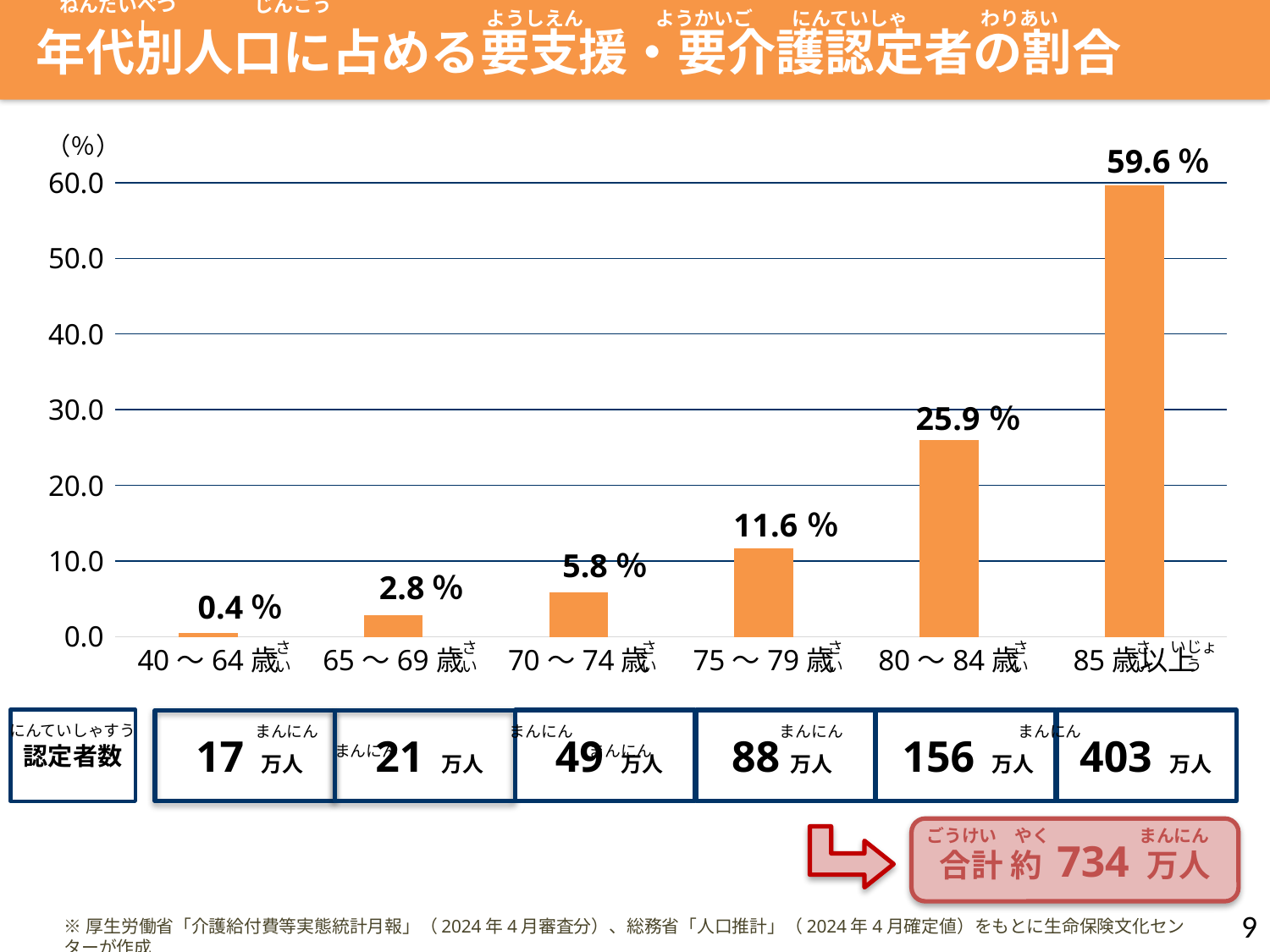
Is the value for 80～84歳 greater or less than 30.0? less What unit is shown at the top of the y axis? (%) Which is larger, the value for 70～74歳 or the value for 65～69歳? 70～74歳 How many age groups are shown on the x axis? 6 Which age group has the lowest share of certified persons? 40～64歳 What is the difference between the values for 80～84歳 and 75～79歳? 14.3 % What is the value for the 75～79歳 age group? 11.6 % What is the value for the 85歳以上 age group? 59.6 % Which age group has the highest share of certified persons? 85歳以上 What is the value for the 40～64歳 age group? 0.4 % What kind of chart is shown on the slide? bar chart Do the values rise or fall as age increases along the x axis? rise